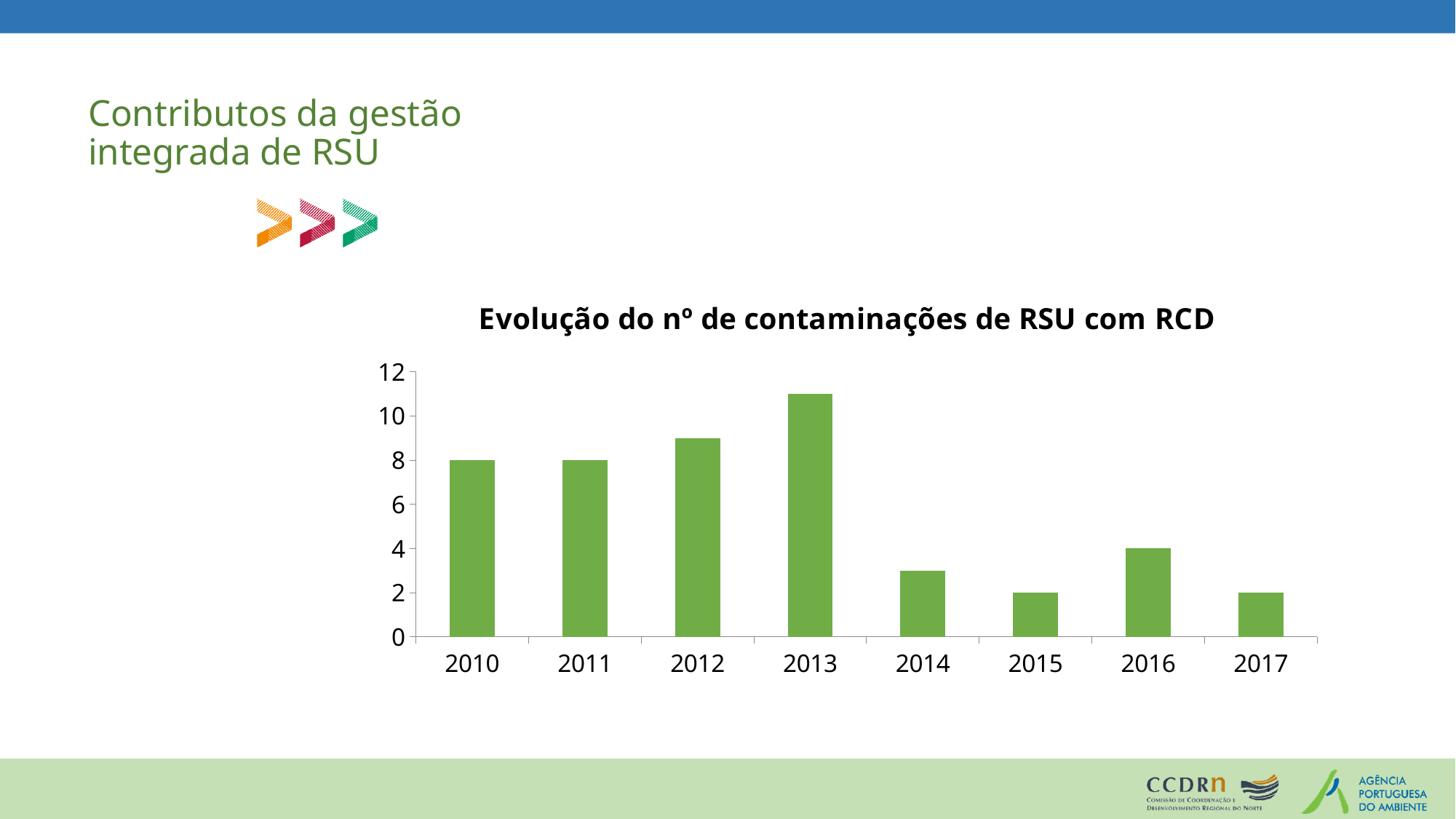
What is the value for 2017? 2 What is the title of the chart? Evolução do nº de contaminações de RSU com RCD What is the difference between the values for 2016 and 2015? 2 Which year has the highest number of contaminations? 2013 Is the value for 2014 greater or less than 4? less What is the value for 2010? 8 Which is larger, the value for 2013 or the value for 2014? 2013 Is the value for 2013 greater or less than 10? greater How many years are shown on the x axis of the chart? 8 What is the value for 2016? 4 Is the value for 2012 greater or less than 8? greater What type of chart is shown on the slide? bar chart